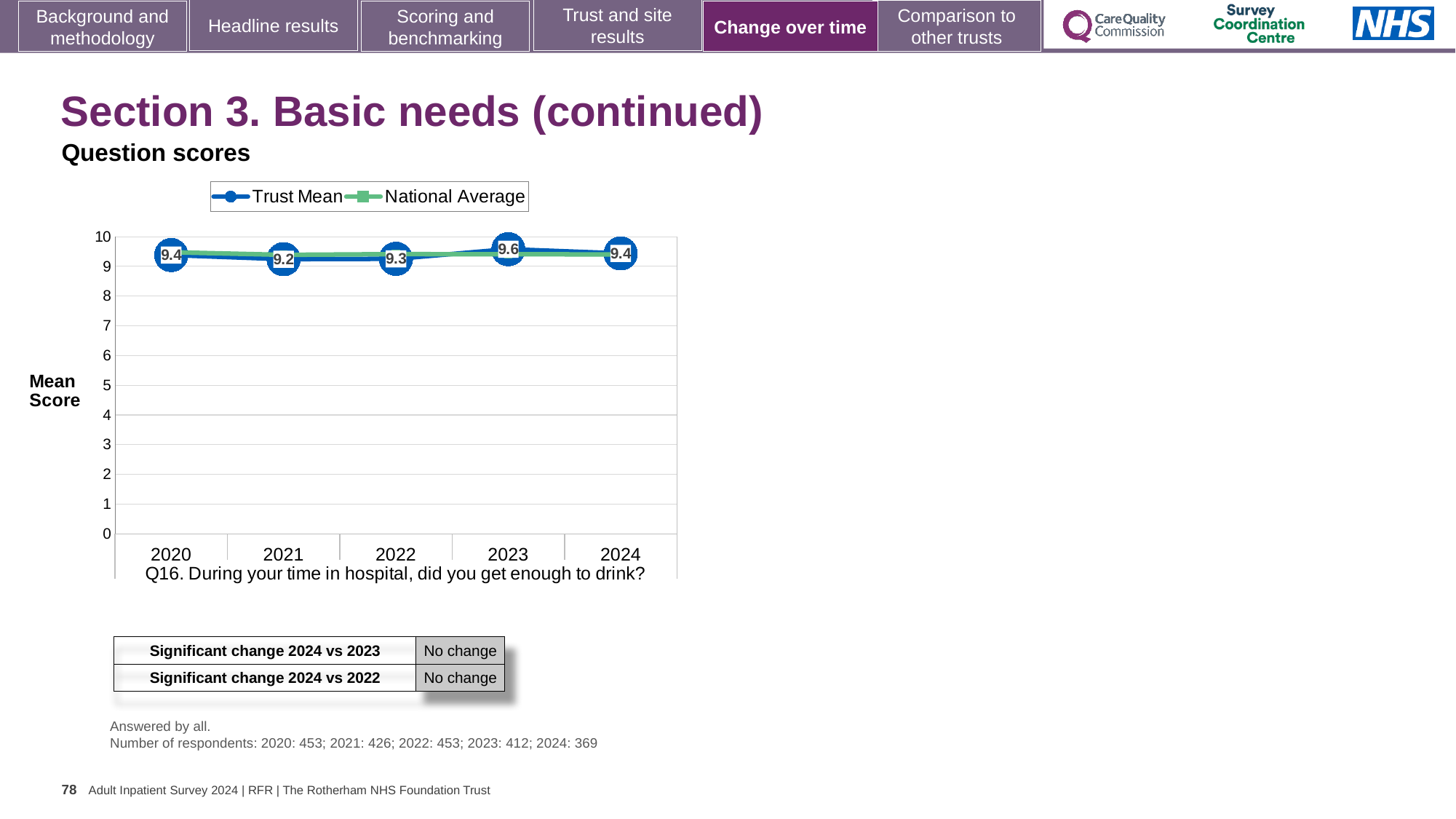
In which year is the Trust Mean highest? 2023 How many series does the legend list? 2 Is the National Average value for 2024 greater or less than 5? greater What is the Trust Mean score for 2020? 9.4 What kind of chart is shown on the slide? line chart What is the difference between the Trust Mean in 2023 and in 2021? 0.4 What is the Trust Mean score for 2023? 9.6 What is the Trust Mean score for 2021? 9.2 Does the Trust Mean rise or fall from 2021 to 2023? rise In which year is the Trust Mean lowest? 2021 How many years are plotted on the x axis? 5 Which year has the larger Trust Mean, 2022 or 2023? 2023